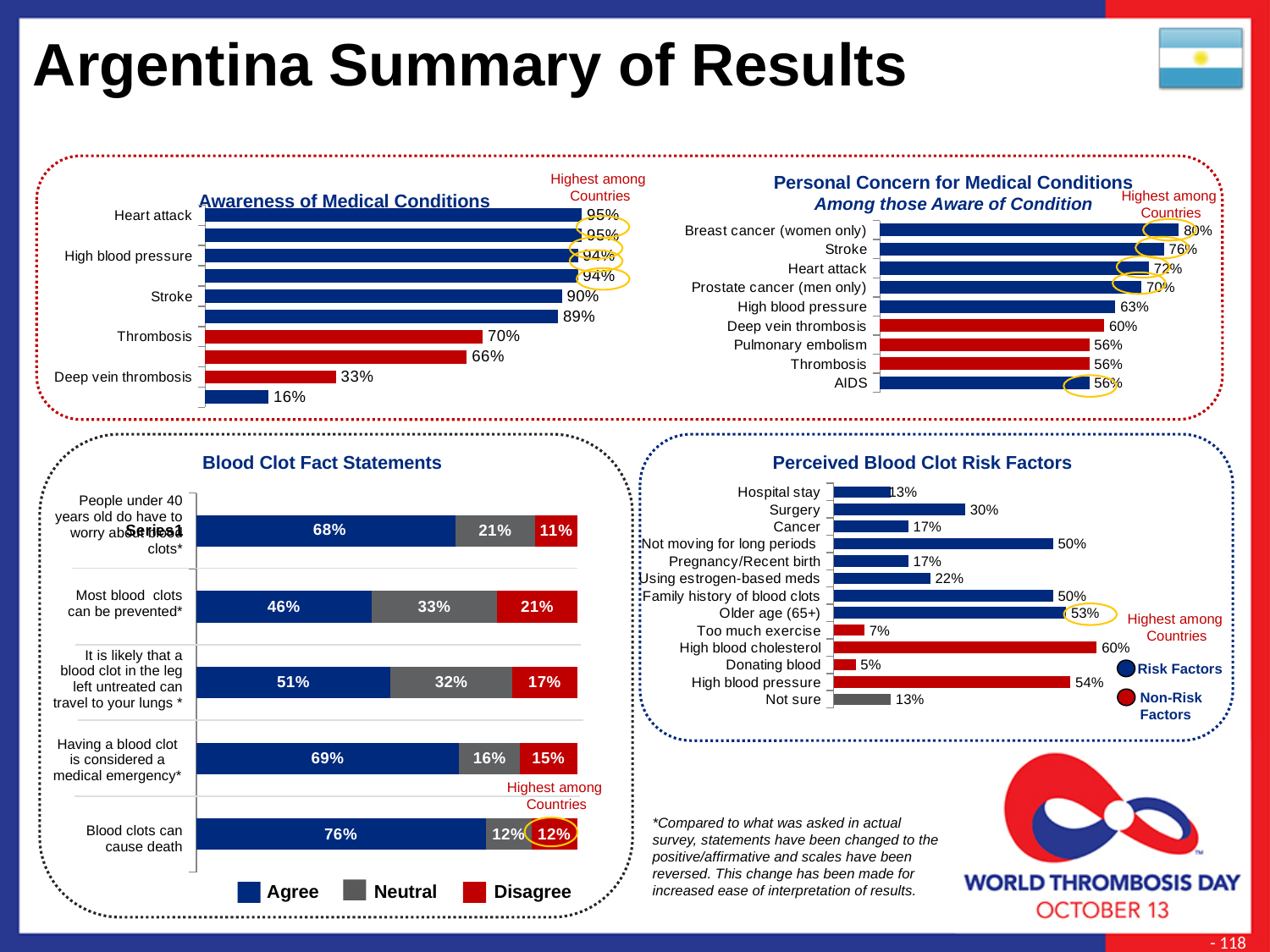
In the Personal Concern for Medical Conditions chart, what is the value for Stroke? 76% In the Blood Clot Fact Statements chart, what is the Neutral value for 'Most blood clots can be prevented'? 33% In the Personal Concern for Medical Conditions chart, what is the difference between Heart attack and High blood pressure? 9% In the Perceived Blood Clot Risk Factors chart, which factor has the highest value? High blood cholesterol In the Blood Clot Fact Statements chart, which statement has the lowest Agree value? Most blood clots can be prevented In the Blood Clot Fact Statements chart, what percentage agree that blood clots can cause death? 76% In the Perceived Blood Clot Risk Factors chart, what is the value for Surgery? 30% In the Personal Concern for Medical Conditions chart, which condition has the highest value? Breast cancer (women only) In the Blood Clot Fact Statements chart, how many series does the legend list? 3 In the Personal Concern for Medical Conditions chart, how many conditions are listed? 9 In the Perceived Blood Clot Risk Factors chart, which is larger, Older age (65+) or High blood pressure? High blood pressure What type of chart is the Awareness of Medical Conditions chart? Bar chart